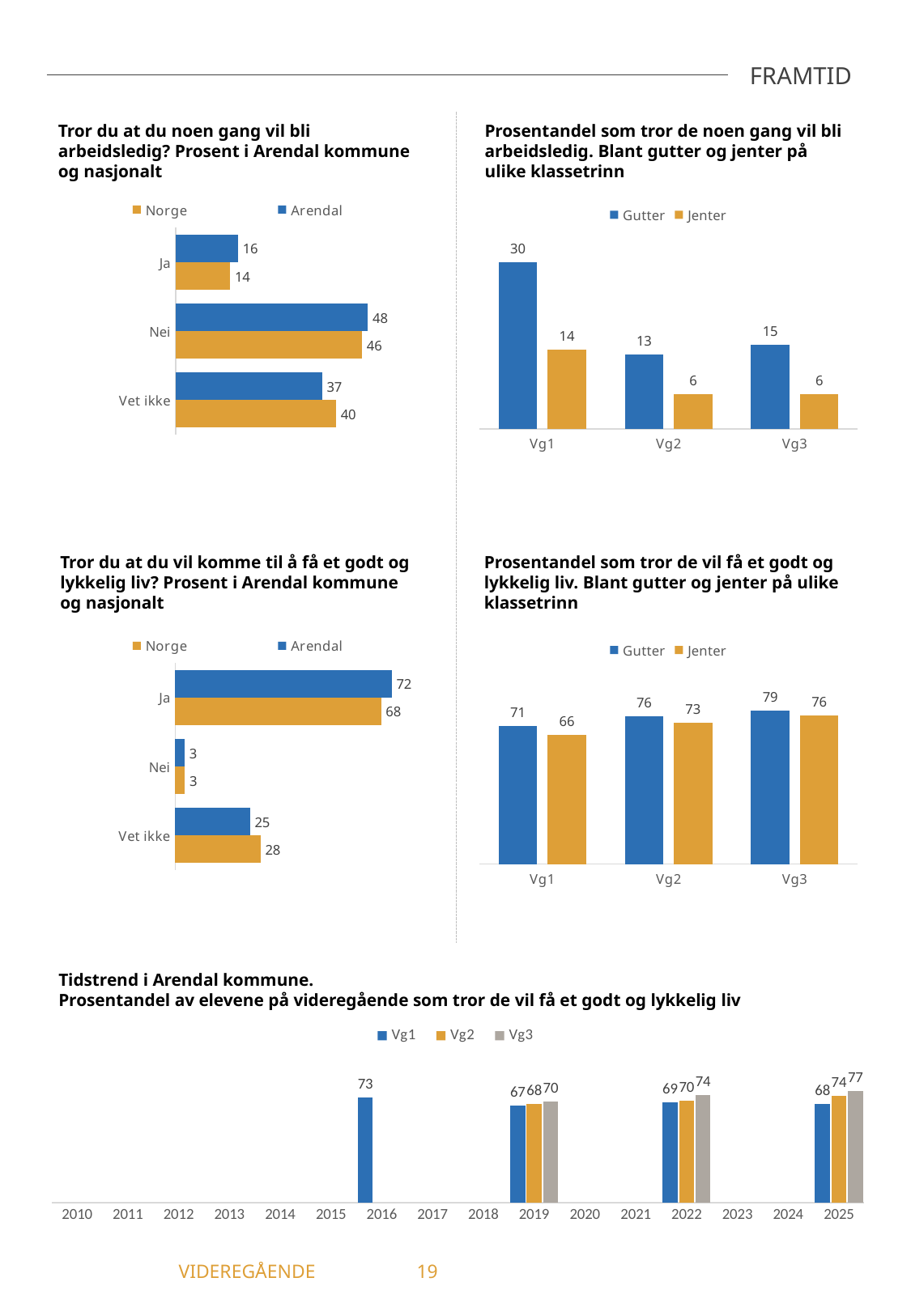
In the top-right chart 'Prosentandel som tror de noen gang vil bli arbeidsledig', what is the value for Jenter at Vg2? 6 In the bottom chart 'Tidstrend i Arendal kommune', what is the difference between the Vg3 and Vg1 values in 2022? 5 In the middle-left chart 'Tror du at du vil komme til å få et godt og lykkelig liv?', which is larger for 'Vet ikke': Norge or Arendal? Norge In the bottom chart 'Tidstrend i Arendal kommune', what is the value for Vg3 in 2025? 77 In the middle-right chart 'Prosentandel som tror de vil få et godt og lykkelig liv', what is the value for Gutter at Vg3? 79 In the middle-right chart 'Prosentandel som tror de vil få et godt og lykkelig liv', do the Jenter values rise or fall from Vg1 to Vg3? rise In the top-left chart 'Tror du at du noen gang vil bli arbeidsledig?', what is the difference between the Norge and Arendal values for 'Vet ikke'? 3 In the top-right chart 'Prosentandel som tror de noen gang vil bli arbeidsledig', how many series does the legend list? 2 In the top-right chart 'Prosentandel som tror de noen gang vil bli arbeidsledig', which class level has the highest value for Gutter? Vg1 In the middle-left chart 'Tror du at du vil komme til å få et godt og lykkelig liv?', what is the value for Norge in the 'Ja' category? 68 In the top-left chart 'Tror du at du noen gang vil bli arbeidsledig?', what is the value for Arendal in the 'Nei' category? 48 What kind of chart is the top-left chart 'Tror du at du noen gang vil bli arbeidsledig?'? bar chart